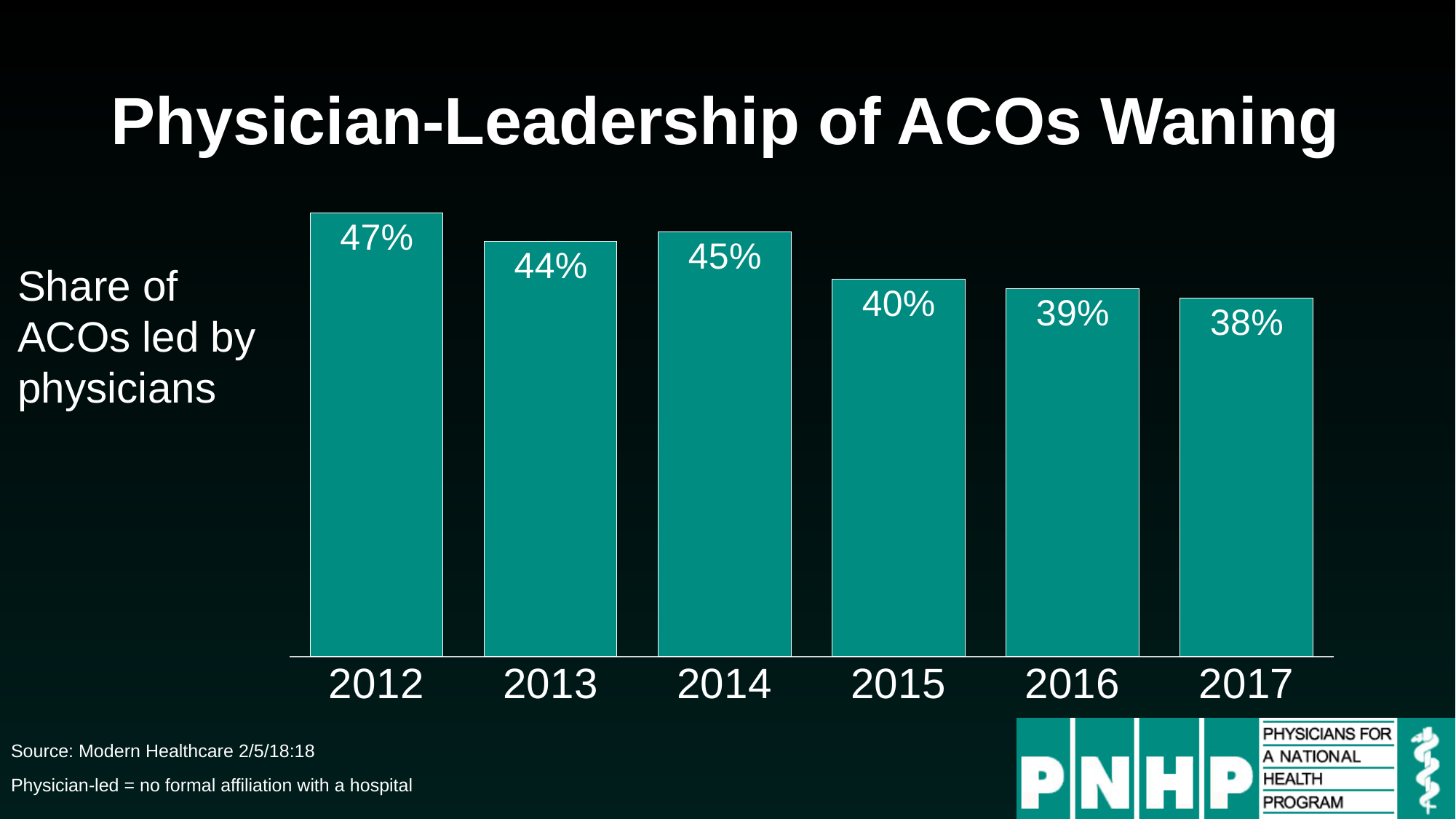
What kind of chart is shown on the slide? Bar chart What share of ACOs were led by physicians in 2012? 47% Which year has the highest share of ACOs led by physicians? 2012 How many years are shown on the chart? 6 What share of ACOs were led by physicians in 2017? 38% Which year has the lowest share of ACOs led by physicians? 2017 What is the title of the slide? Physician-Leadership of ACOs Waning What is the value shown for 2015? 40% By how many percentage points did the share of physician-led ACOs fall from 2012 to 2017? 9 percentage points What is the difference between the 2014 and 2013 values? 1 percentage point Which year has a larger share of physician-led ACOs, 2013 or 2014? 2014 Overall, does the share of ACOs led by physicians rise or fall from 2012 to 2017? Fall